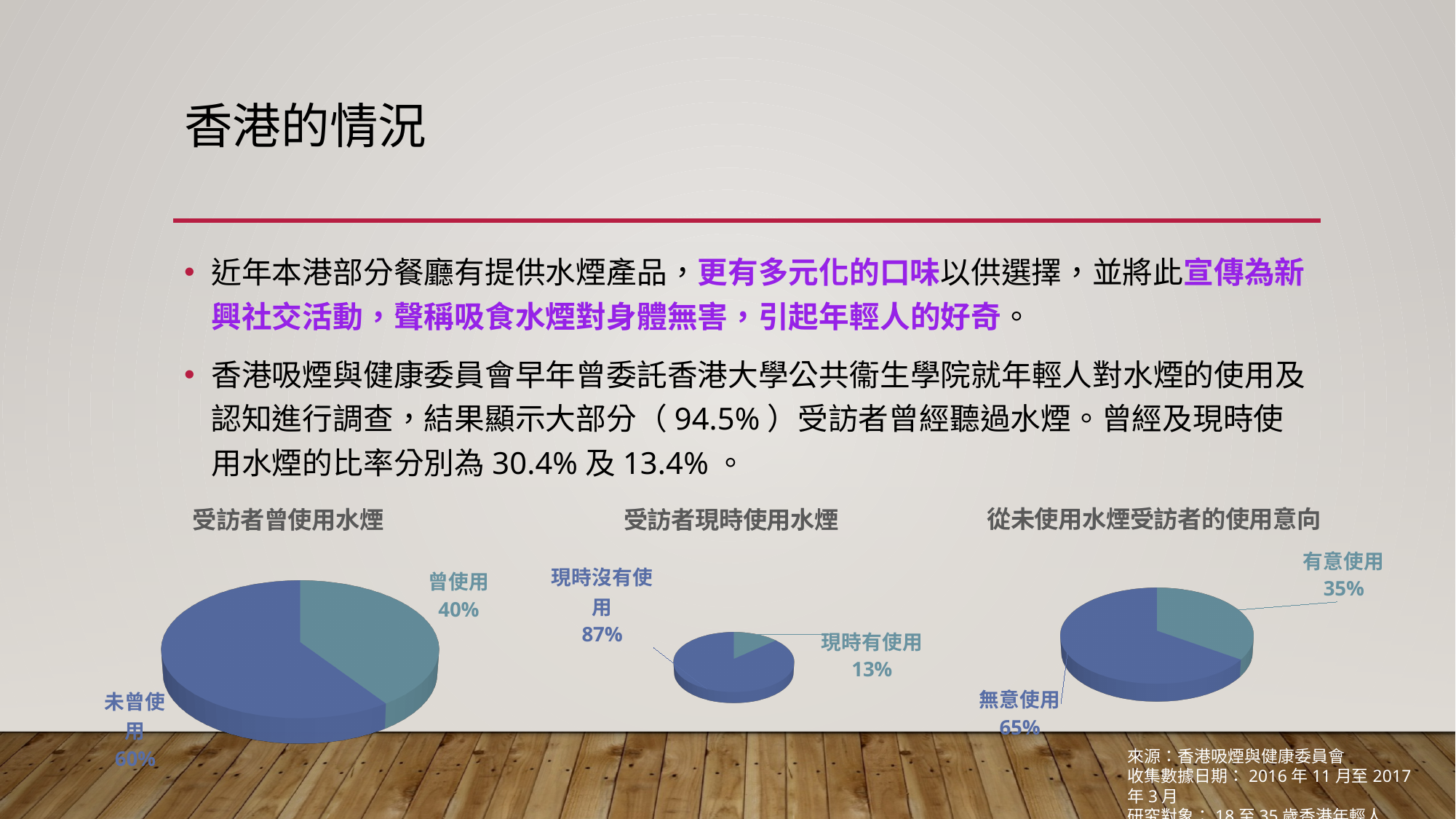
In the chart titled 受訪者現時使用水煙, what percentage is labelled 現時有使用? 13% In the chart titled 從未使用水煙受訪者的使用意向, which is larger, 有意使用 or 無意使用? 無意使用 In the chart titled 從未使用水煙受訪者的使用意向, what percentage is labelled 有意使用? 35% In the chart titled 受訪者曾使用水煙, what is the difference between the 未曾使用 and 曾使用 percentages? 20% In the chart titled 受訪者曾使用水煙, what percentage is labelled 未曾使用? 60% In the chart titled 受訪者曾使用水煙, what percentage is labelled 曾使用? 40% In the chart titled 受訪者現時使用水煙, what percentage is labelled 現時沒有使用? 87% In the chart titled 受訪者現時使用水煙, which slice is the smallest? 現時有使用 What type of chart is the chart titled 受訪者曾使用水煙? Pie chart How many pie charts are shown on the slide? 3 In the chart titled 從未使用水煙受訪者的使用意向, which slice is the largest? 無意使用 In the chart titled 受訪者現時使用水煙, what is the difference between the 現時沒有使用 and 現時有使用 percentages? 74%